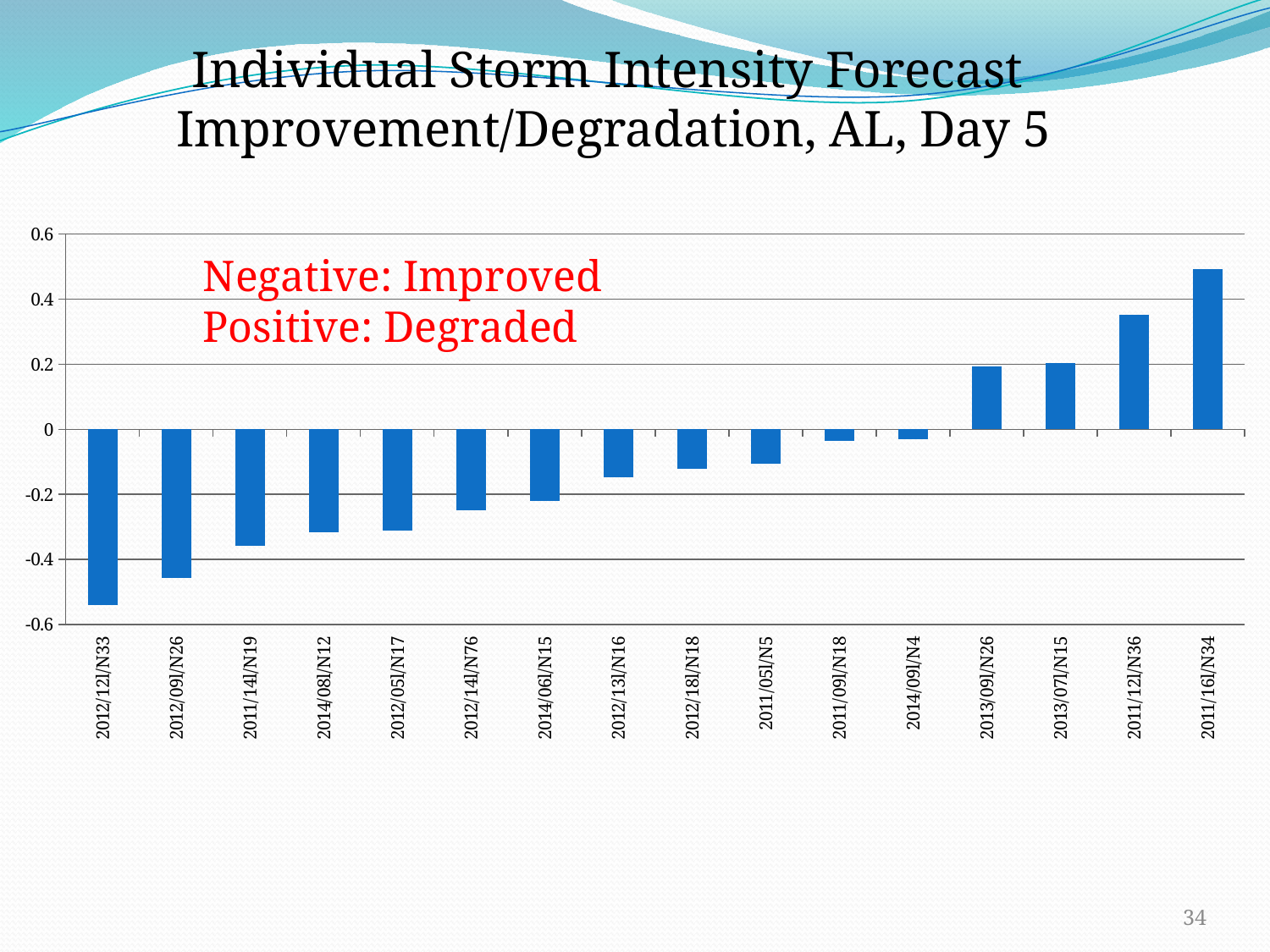
Is the value for 2011/16l/N34 greater or less than 0.4? greater Which storm has the lowest (most negative) value? 2012/12l/N33 How many storm categories are plotted along the x axis? 16 Is the value for 2012/14l/N76 greater or less than -0.2? less Is the value for 2012/12l/N33 greater or less than -0.4? less Which has the larger value, 2011/12l/N36 or 2013/09l/N26? 2011/12l/N36 According to the red annotation on the chart, what does a negative value indicate? Improved Which storm has the highest (most positive) value? 2011/16l/N34 What kind of chart is shown on the slide? Bar chart Do the bar values generally rise or fall moving from left to right along the x axis? Rise Which has the larger value, 2012/09l/N26 or 2012/13l/N16? 2012/13l/N16